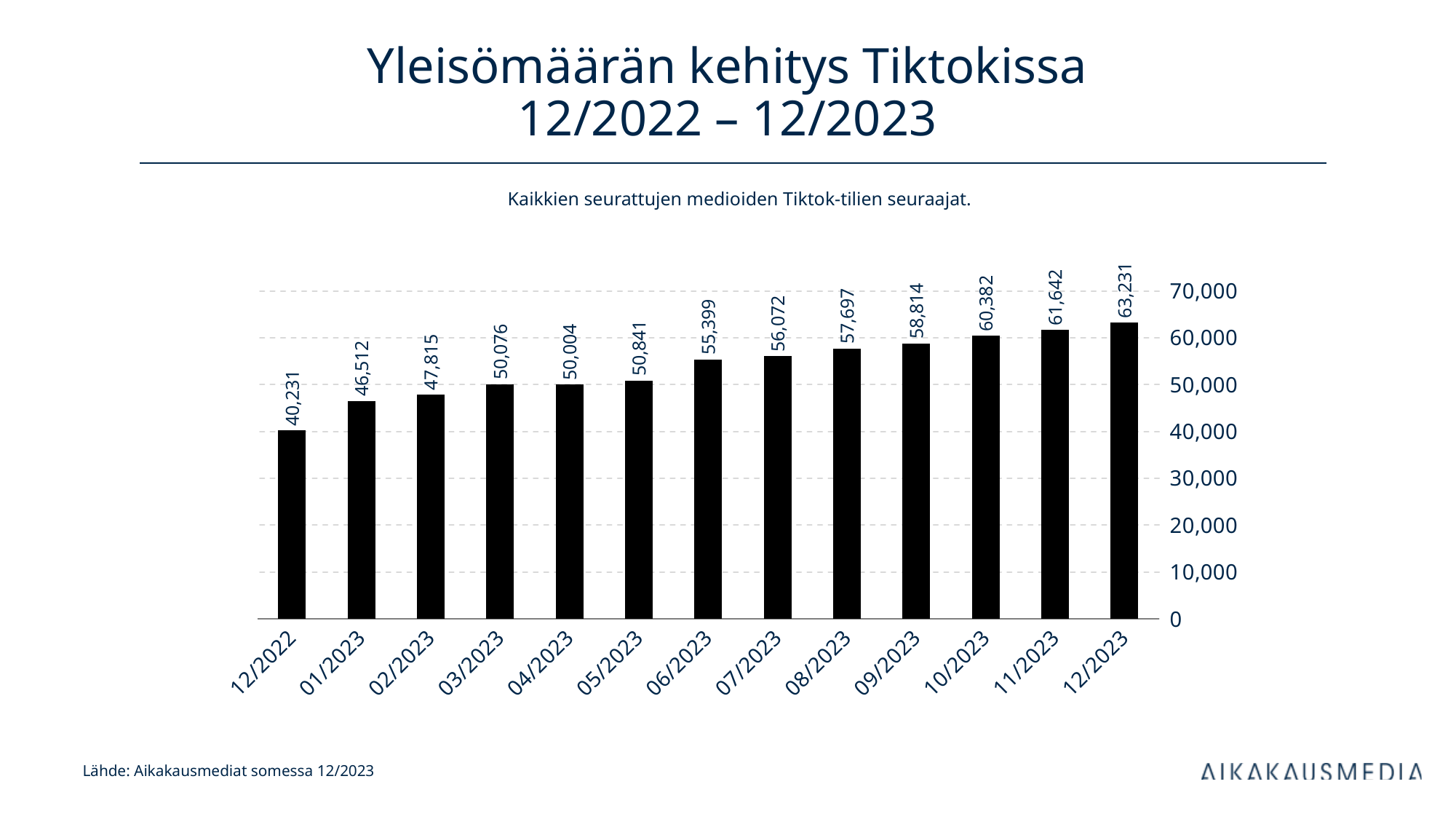
What is the difference between the values for 12/2023 and 12/2022? 23,000 Do the values generally rise or fall from 12/2022 to 12/2023? rise What is the title of the chart? Yleisömäärän kehitys Tiktokissa 12/2022 – 12/2023 What is the value for 06/2023? 55,399 What is the value for 12/2022? 40,231 Which is larger, the value for 03/2023 or the value for 04/2023? 03/2023 Which month has the lowest value? 12/2022 Is the value for 09/2023 greater or less than 50,000? greater What kind of chart is shown on the slide? bar chart What is the value for 12/2023? 63,231 How many months are shown on the x axis? 13 Which month has the highest value? 12/2023